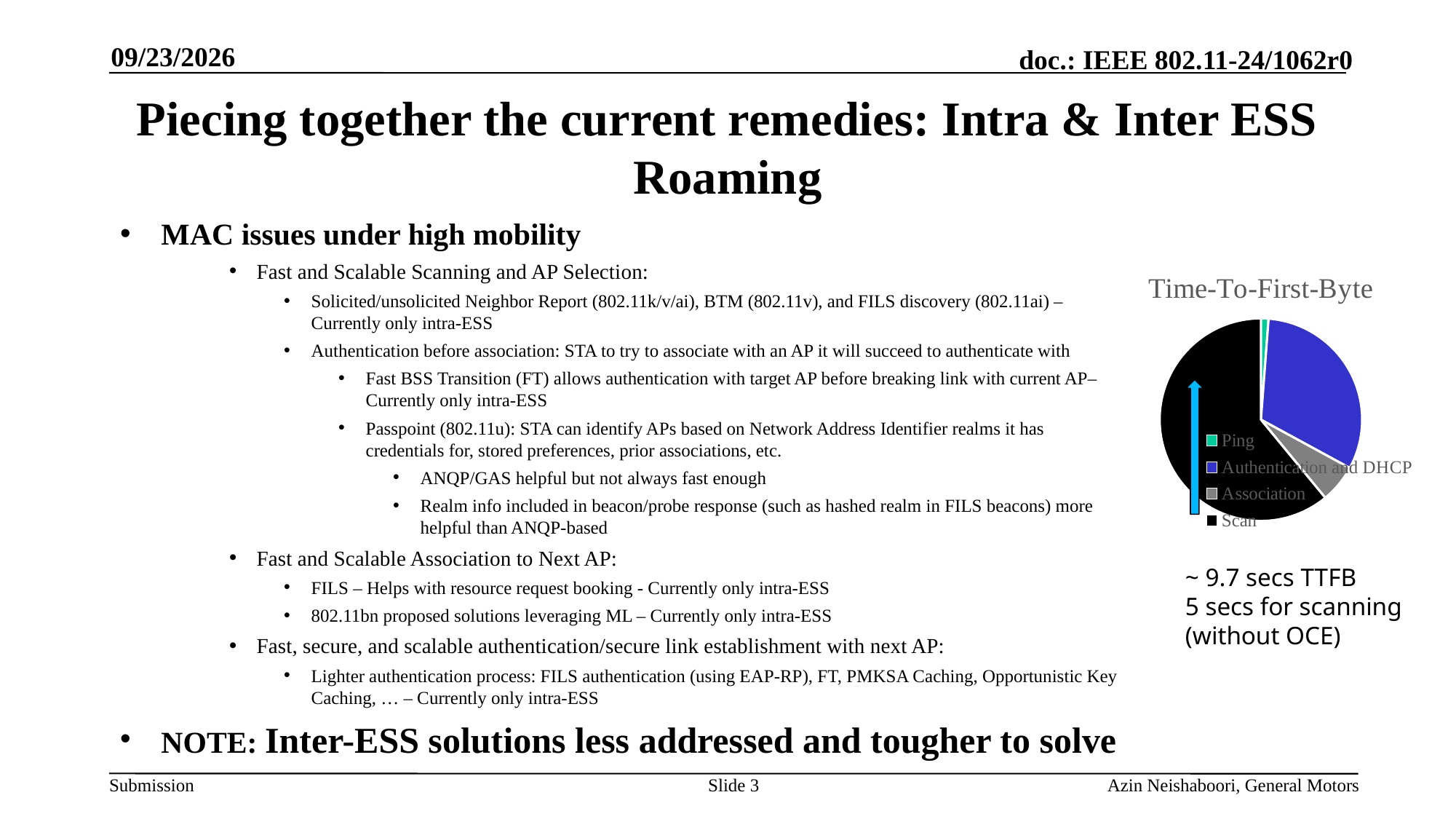
What colour is the Scan slice in the Time-To-First-Byte pie chart? black In the Time-To-First-Byte pie chart, which slice is larger: Association or Ping? Association How many categories does the legend of the Time-To-First-Byte pie chart list? 4 Which category takes the largest share of the Time-To-First-Byte pie chart? Scan In the Time-To-First-Byte pie chart, which slice is larger: Authentication and DHCP or Association? Authentication and DHCP What kind of chart is shown on the slide? pie chart In the Time-To-First-Byte pie chart, which slice is larger: Scan or Authentication and DHCP? Scan What is the title of the chart on the slide? Time-To-First-Byte Which category takes the smallest share of the Time-To-First-Byte pie chart? Ping